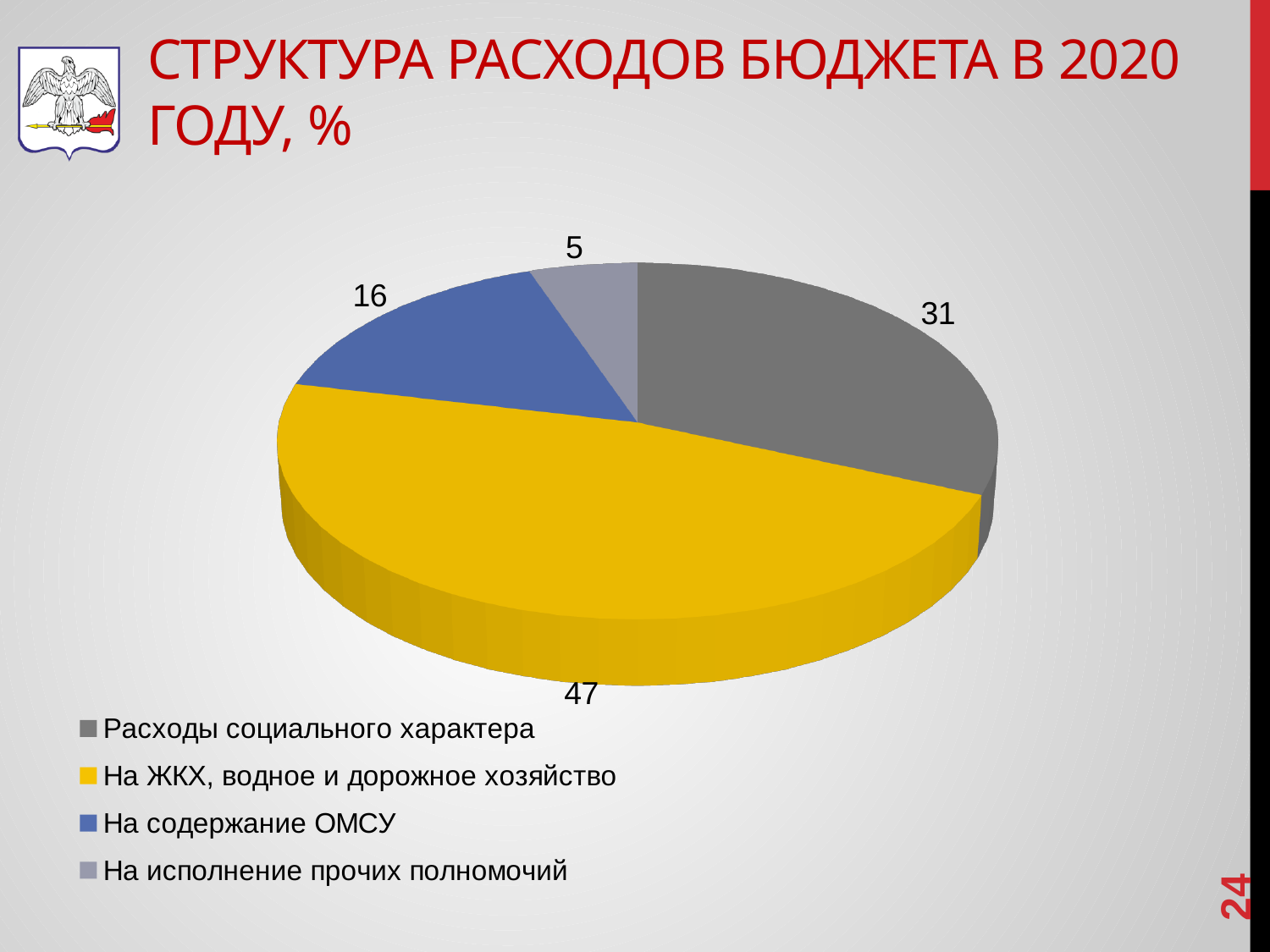
What is the difference between the values for «На ЖКХ, водное и дорожное хозяйство» and «Расходы социального характера»? 16 What value is shown for «На содержание ОМСУ»? 16 What is the title of the chart? СТРУКТУРА РАСХОДОВ БЮДЖЕТА В 2020 ГОДУ, % What value is shown for «Расходы социального характера»? 31 What kind of chart is shown on the slide? Pie chart Which category has the smallest slice? На исполнение прочих полномочий How many slices does the pie chart have? 4 What value is shown for «На исполнение прочих полномочий»? 5 Which is larger: «На содержание ОМСУ» or «На исполнение прочих полномочий»? На содержание ОМСУ What value is shown for «На ЖКХ, водное и дорожное хозяйство»? 47 What colour is the slice for «На содержание ОМСУ»? Blue Which category has the largest slice? На ЖКХ, водное и дорожное хозяйство